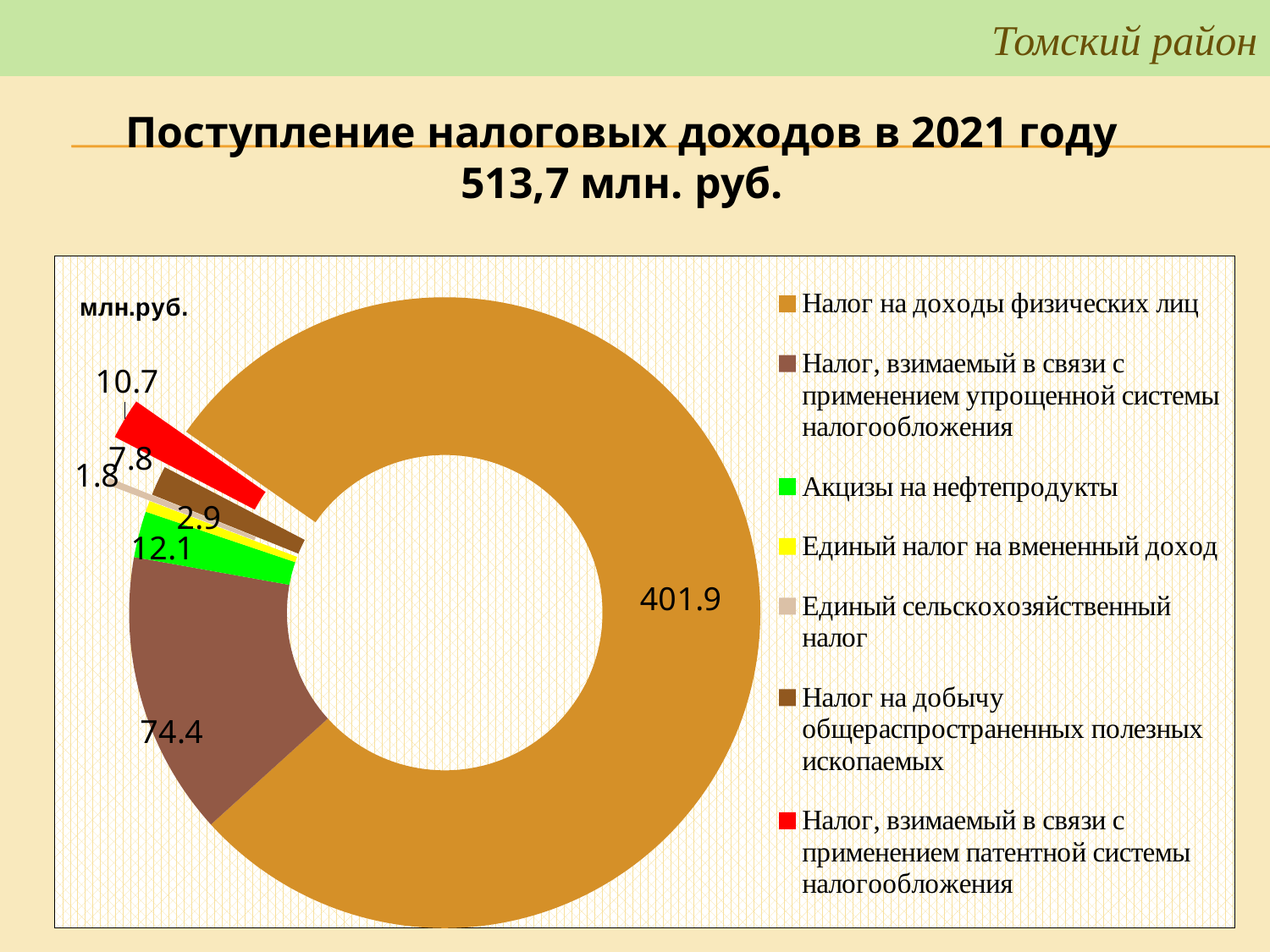
What unit is indicated in the top-left corner of the chart? млн.руб. What is the difference between the values for Налог на доходы физических лиц and Налог, взимаемый в связи с применением упрощенной системы налогообложения? 327.5 What is the value for Налог, взимаемый в связи с применением патентной системы налогообложения? 10.7 What is the value for Налог на доходы физических лиц? 401.9 What is the value for Налог, взимаемый в связи с применением упрощенной системы налогообложения? 74.4 What is the value for Акцизы на нефтепродукты? 12.1 Which is larger: Акцизы на нефтепродукты or Налог на добычу общераспространенных полезных ископаемых? Акцизы на нефтепродукты What type of chart is shown on the slide? doughnut chart Which category has the largest value? Налог на доходы физических лиц What is the value for Единый сельскохозяйственный налог? 1.8 How many categories does the legend list? 7 Which category has the smallest value? Единый сельскохозяйственный налог